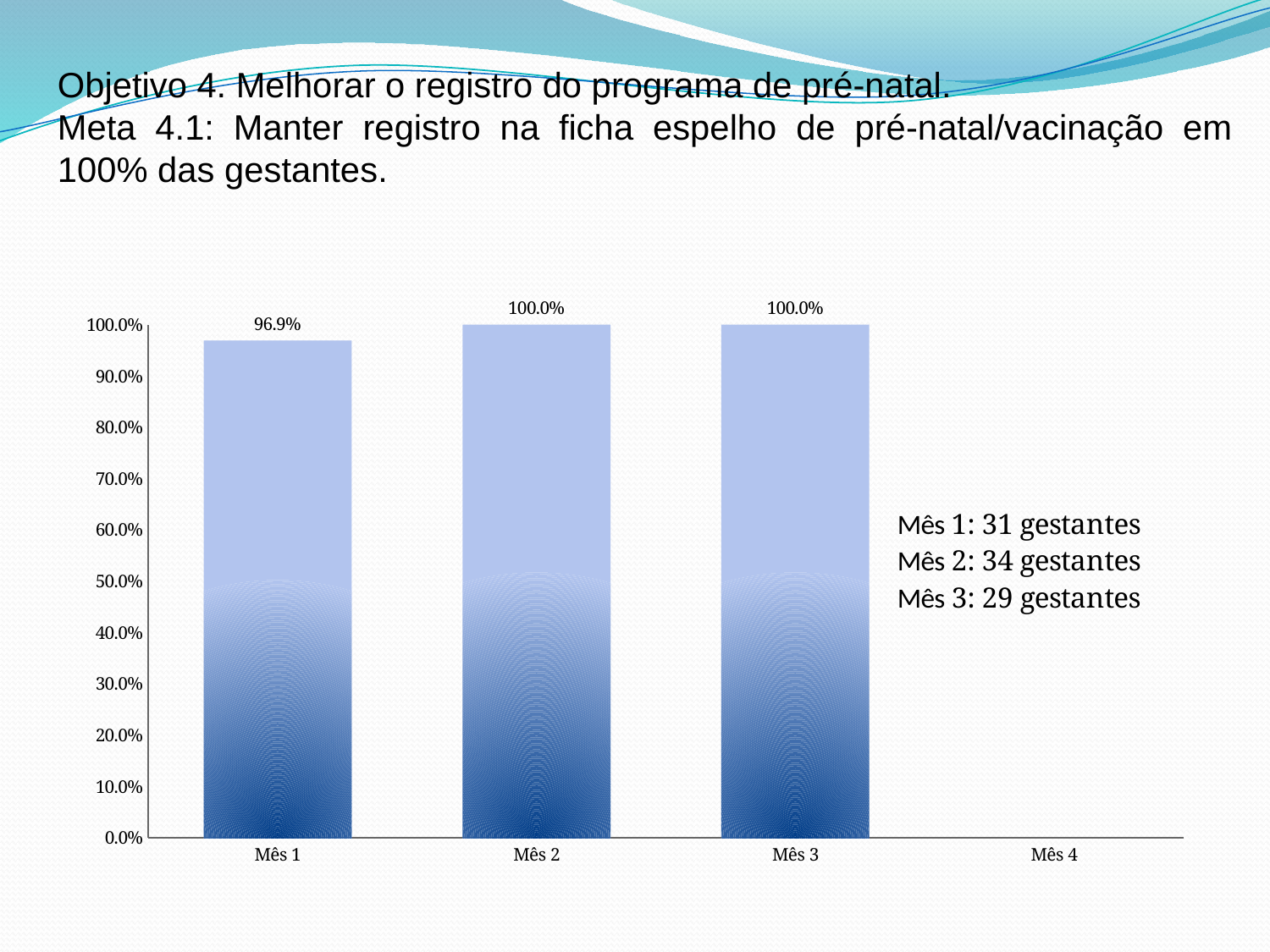
Which is larger, the value for Mês 1 or the value for Mês 3? Mês 3 How many bars are plotted in the chart? 3 Which months reach 100.0%? Mês 2 and Mês 3 What is the value for Mês 1? 96.9% What kind of chart is shown on the slide? bar chart What is the difference between the values for Mês 2 and Mês 1? 3.1% According to the text next to the chart, how many gestantes were there in Mês 2? 34 gestantes What is the value for Mês 3? 100.0% Is the value for Mês 1 greater or less than 90.0%? greater What is the value for Mês 2? 100.0% Does the value rise or fall from Mês 1 to Mês 2? rise